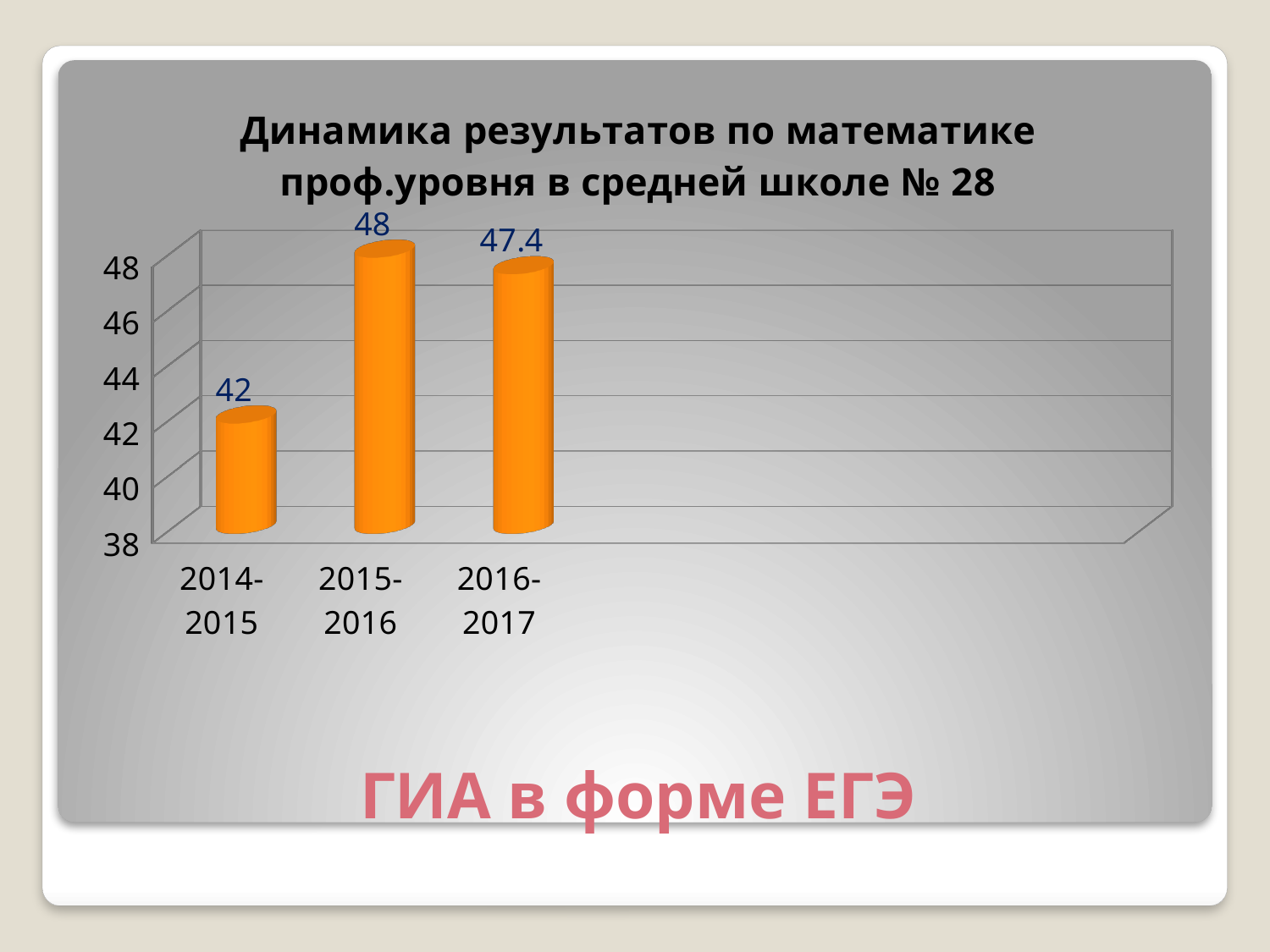
What is the value for 2014-2015? 42 What is the difference between the values for 2015-2016 and 2014-2015? 6 Which year has the highest value? 2015-2016 What is the difference between the values for 2015-2016 and 2016-2017? 0.6 Is the value for 2014-2015 greater or less than 44? less What is the value for 2016-2017? 47.4 What is the title of the chart? Динамика результатов по математике проф.уровня в средней школе № 28 How many categories are shown on the x axis? 3 What is the value for 2015-2016? 48 Which year has the lowest value? 2014-2015 What kind of chart is shown on the slide? bar chart Which is larger, the value for 2014-2015 or the value for 2016-2017? 2016-2017